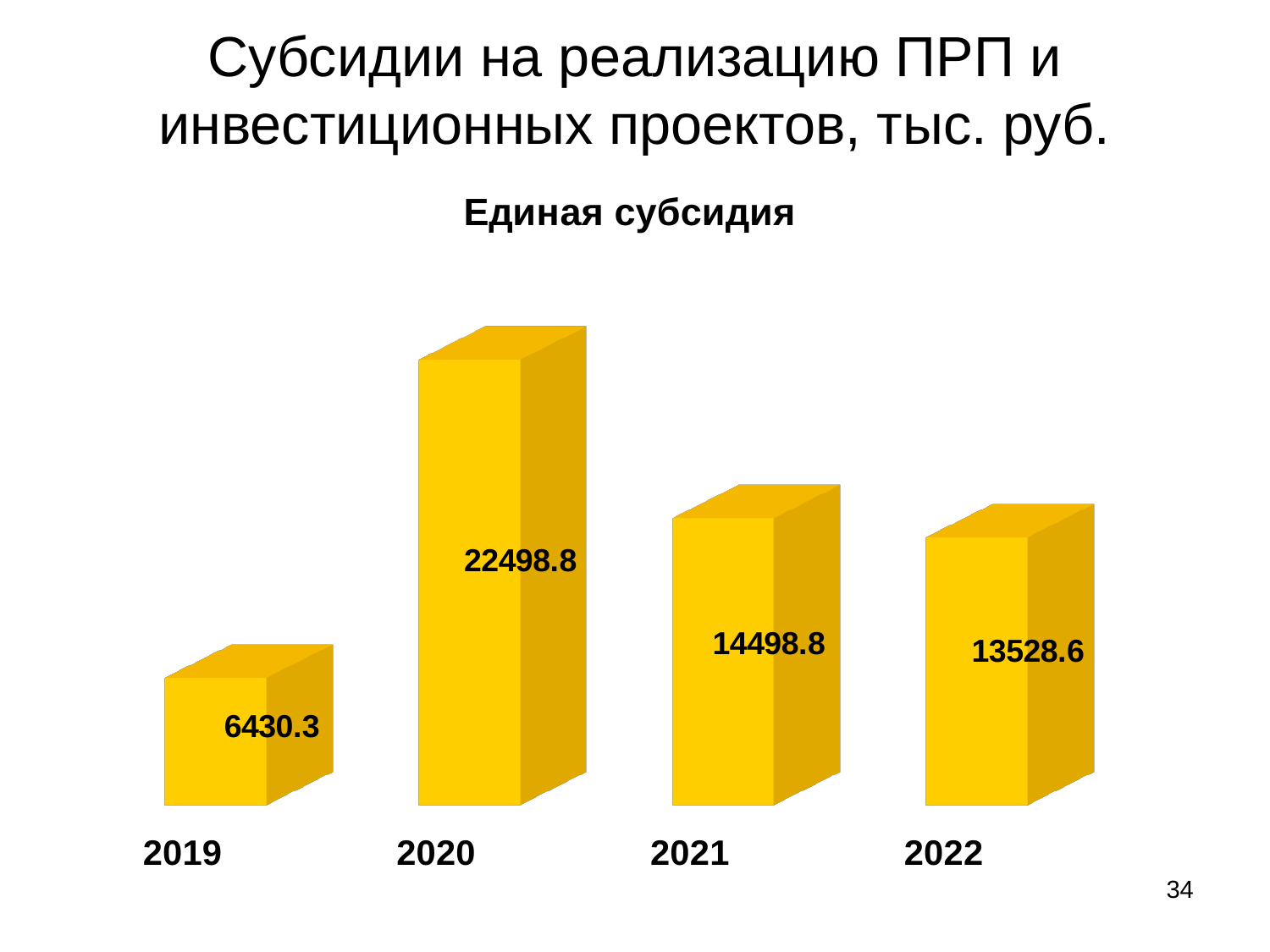
What is the title of the chart? Единая субсидия How many years are shown on the chart? 4 Do the values rise or fall from 2020 to 2022? fall What kind of chart is this? bar chart Which is larger, the value for 2021 or the value for 2022? 2021 What is the difference between the values for 2021 and 2022? 970.2 Which year has the highest value? 2020 What is the value for 2022? 13528.6 What is the value for 2020? 22498.8 What is the difference between the values for 2020 and 2021? 8000 What is the value for 2019? 6430.3 Which year has the lowest value? 2019